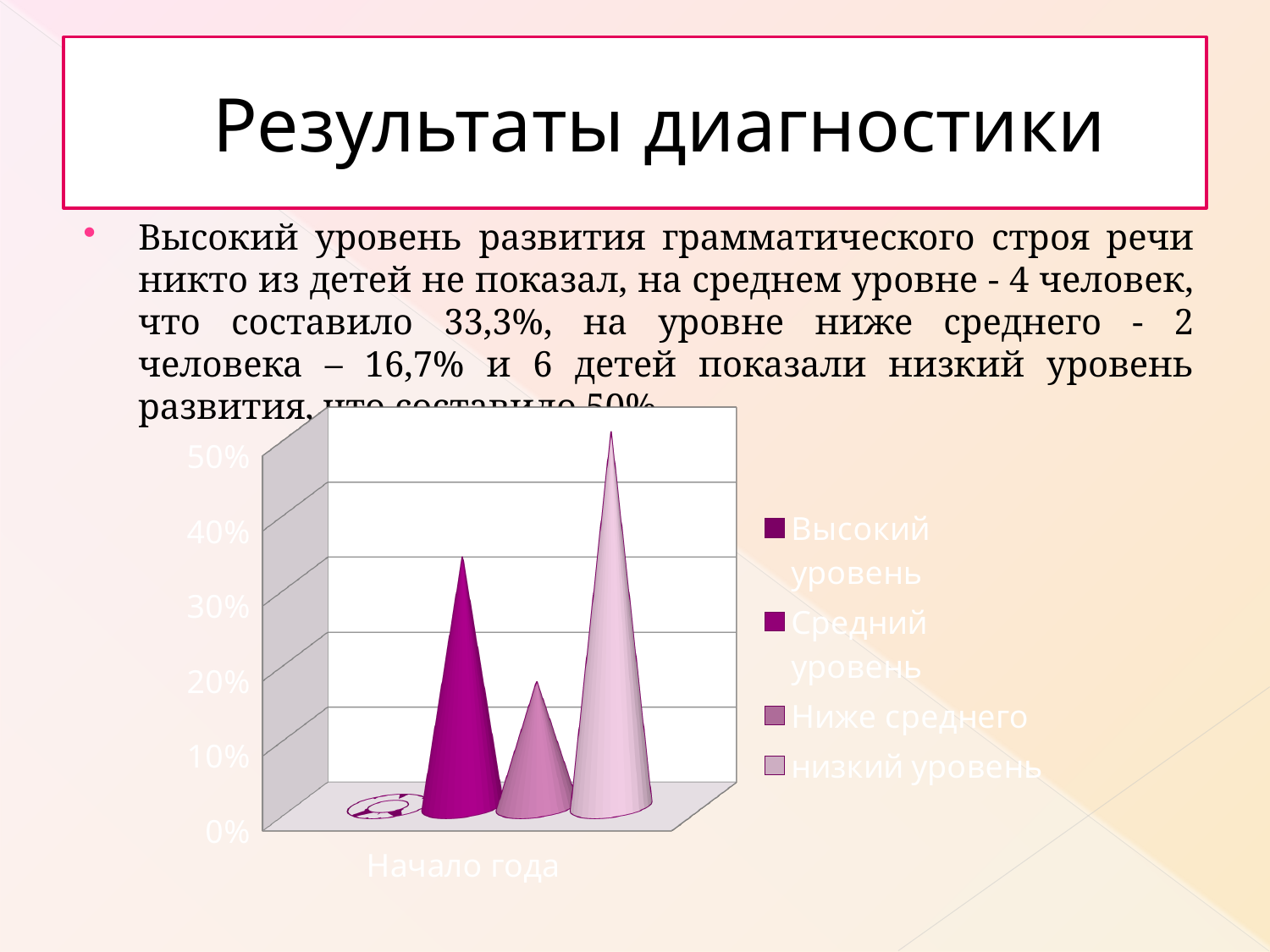
Which is larger in the chart, the value for Средний уровень or the value for Ниже среднего? Средний уровень Is the value for Средний уровень greater or less than 30%? greater Is the value for Ниже среднего greater or less than 10%? greater Which series has the lowest value in the chart? Высокий уровень Is the value for Средний уровень greater or less than 40%? less What kind of chart is shown on the slide? bar chart How many categories are shown on the x axis of the chart? 1 Which series has the highest value in the chart? низкий уровень What is the label of the category on the x axis of the chart? Начало года How many series does the chart legend list? 4